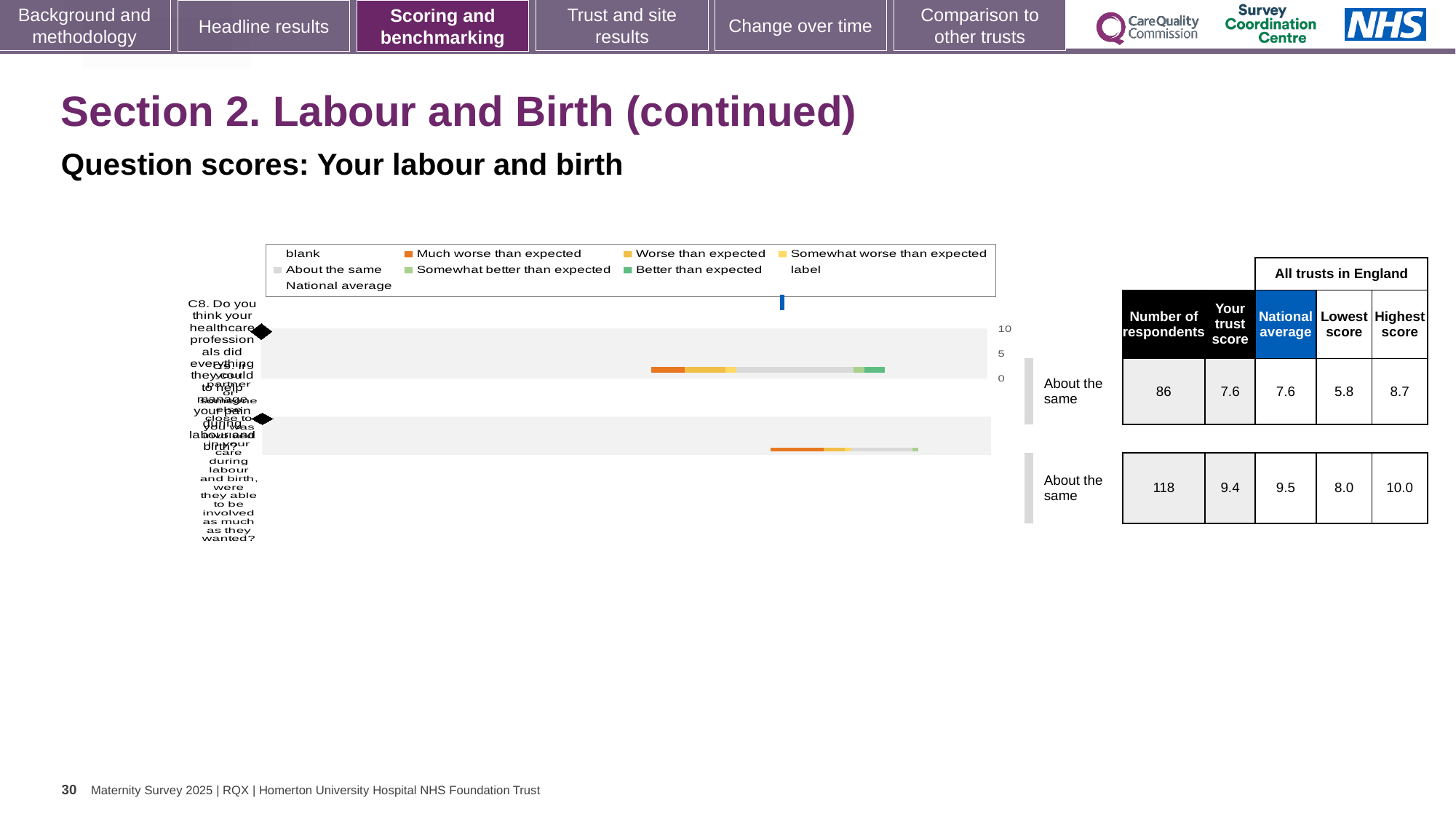
For the second row of the table, which is larger: the trust score or the national average? National average In the table, what is the national average for the second row? 9.5 In the table, what is the lowest score among all trusts in England for the first row (question C8)? 5.8 What kind of chart is shown on the slide? bar chart What is the highest value shown on the chart's numeric axis? 10 What is the difference between the highest score and the lowest score for the first row (question C8) in the table? 2.9 In the table, what is the highest score among all trusts in England for the second row? 10.0 How many questions (rows) are plotted in the chart? 2 What colour represents 'Much worse than expected' in the chart legend? Orange In the table, what is the trust score for the first row (question C8)? 7.6 What benchmark category is shown for both questions on the slide? About the same In the table next to the chart, how many respondents are shown for the first row (question C8)? 86